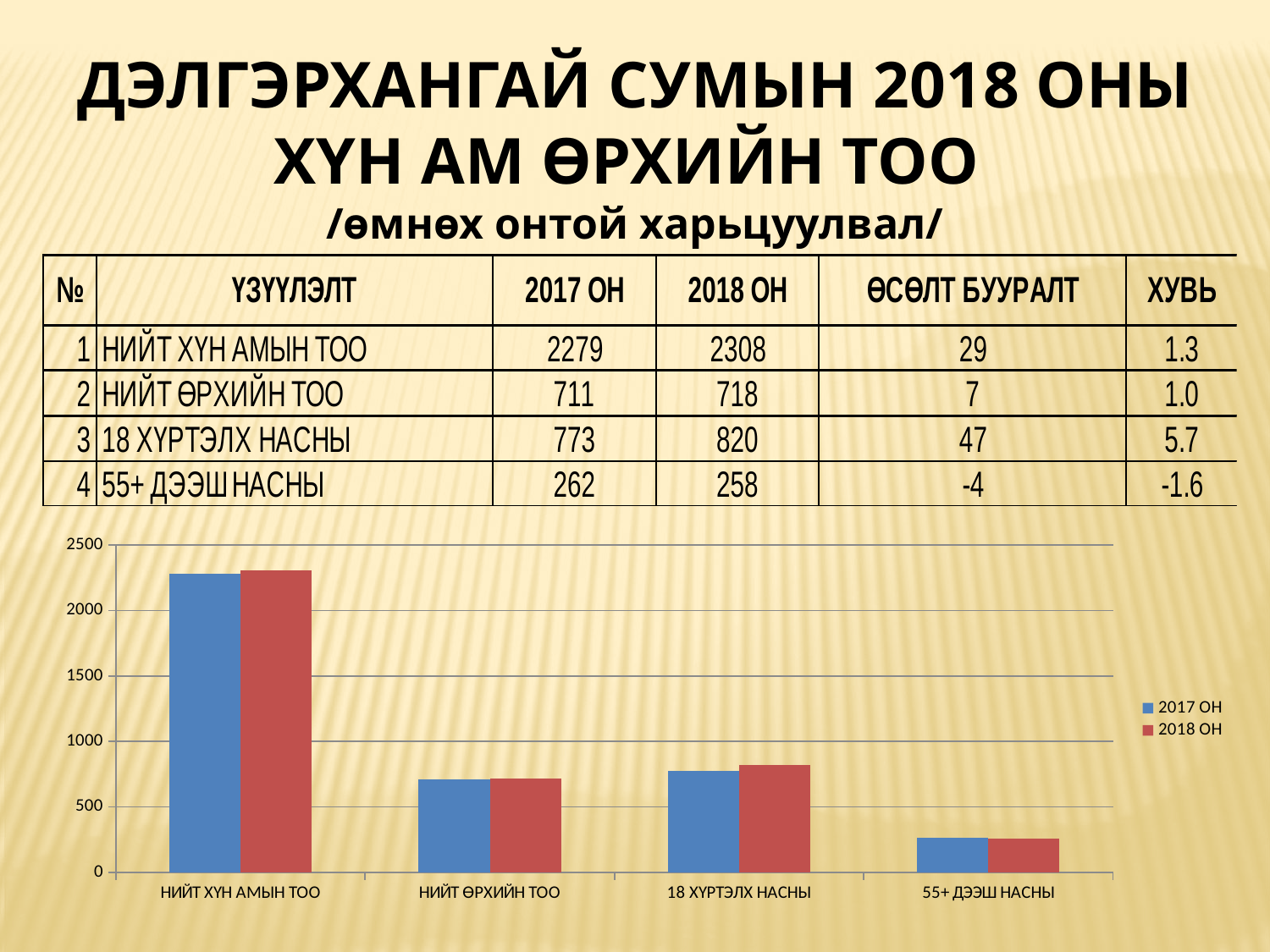
What kind of chart is shown on the slide? bar chart Is the 2017 ОН value for 55+ ДЭЭШ НАСНЫ greater or less than 500? less What is the difference between the 2018 ОН and 2017 ОН values for НИЙТ ХҮН АМЫН ТОО? 29 How many categories are shown on the x axis of the chart? 4 Which category has the highest bars in the chart? НИЙТ ХҮН АМЫН ТОО Is the 2018 ОН value for 18 ХҮРТЭЛХ НАСНЫ greater or less than 1000? less How many series does the chart legend list? 2 What is the 2017 ОН value for НИЙТ ӨРХИЙН ТОО, as printed in the table? 711 What is the 2018 ОН value for 18 ХҮРТЭЛХ НАСНЫ, as printed in the table? 820 Which series is shown in red in the chart? 2018 ОН Which category has the lowest bars in the chart? 55+ ДЭЭШ НАСНЫ Is the 2018 ОН value for НИЙТ ХҮН АМЫН ТОО greater or less than 2000? greater